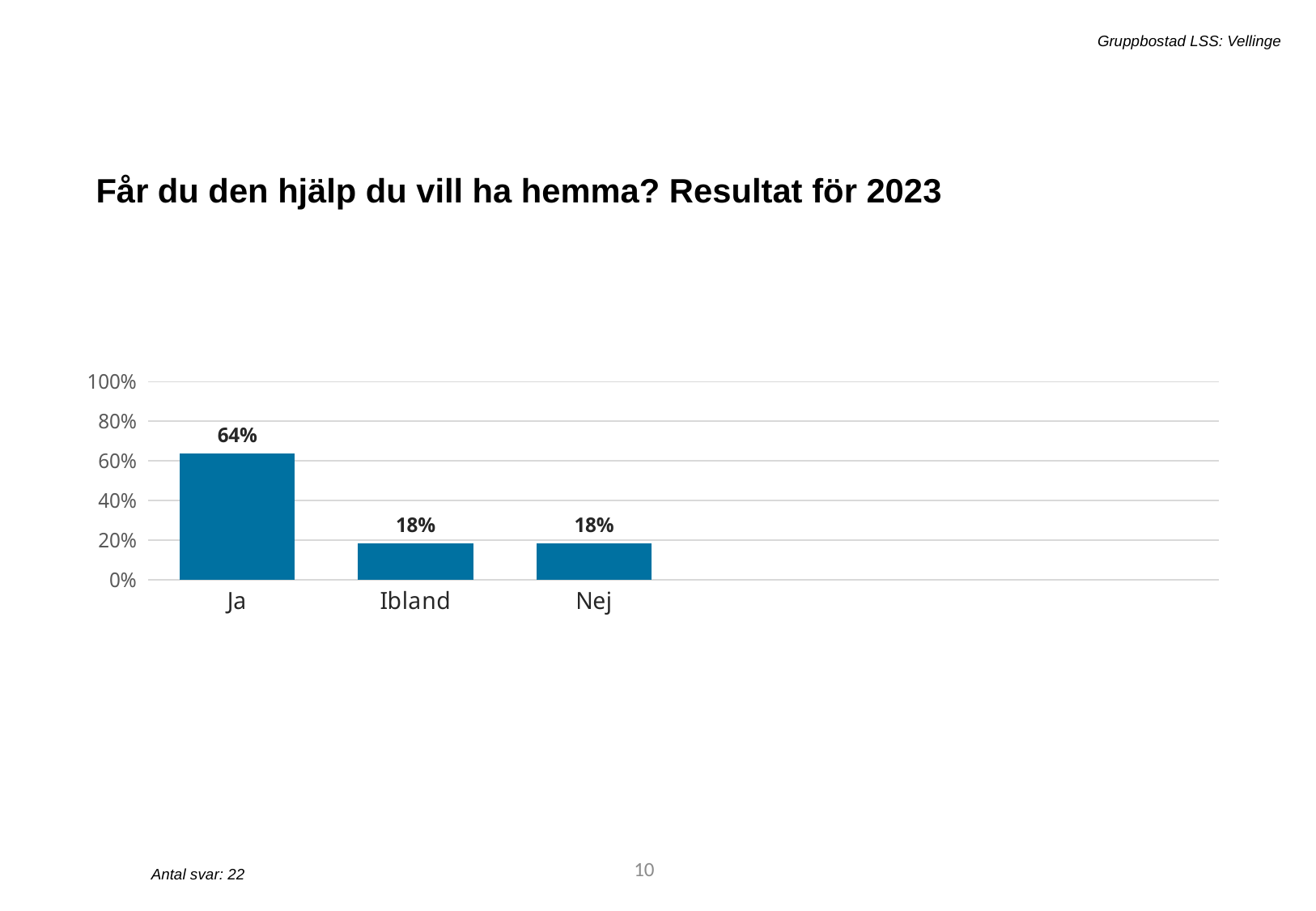
What is the value for Nej? 18% Is the value for Ja greater or less than 60%? greater What is the value for Ja? 64% What kind of chart is shown on the slide? bar chart Is the value for Nej greater or less than 20%? less What is the difference between the values for Ja and Ibland? 46% Which is larger, the value for Ja or the value for Ibland? Ja What is the difference between the values for Ja and Nej? 46% What is the title of the slide? Får du den hjälp du vill ha hemma? Resultat för 2023 Which category has the highest value? Ja What is the value for Ibland? 18% How many categories are shown on the x axis? 3